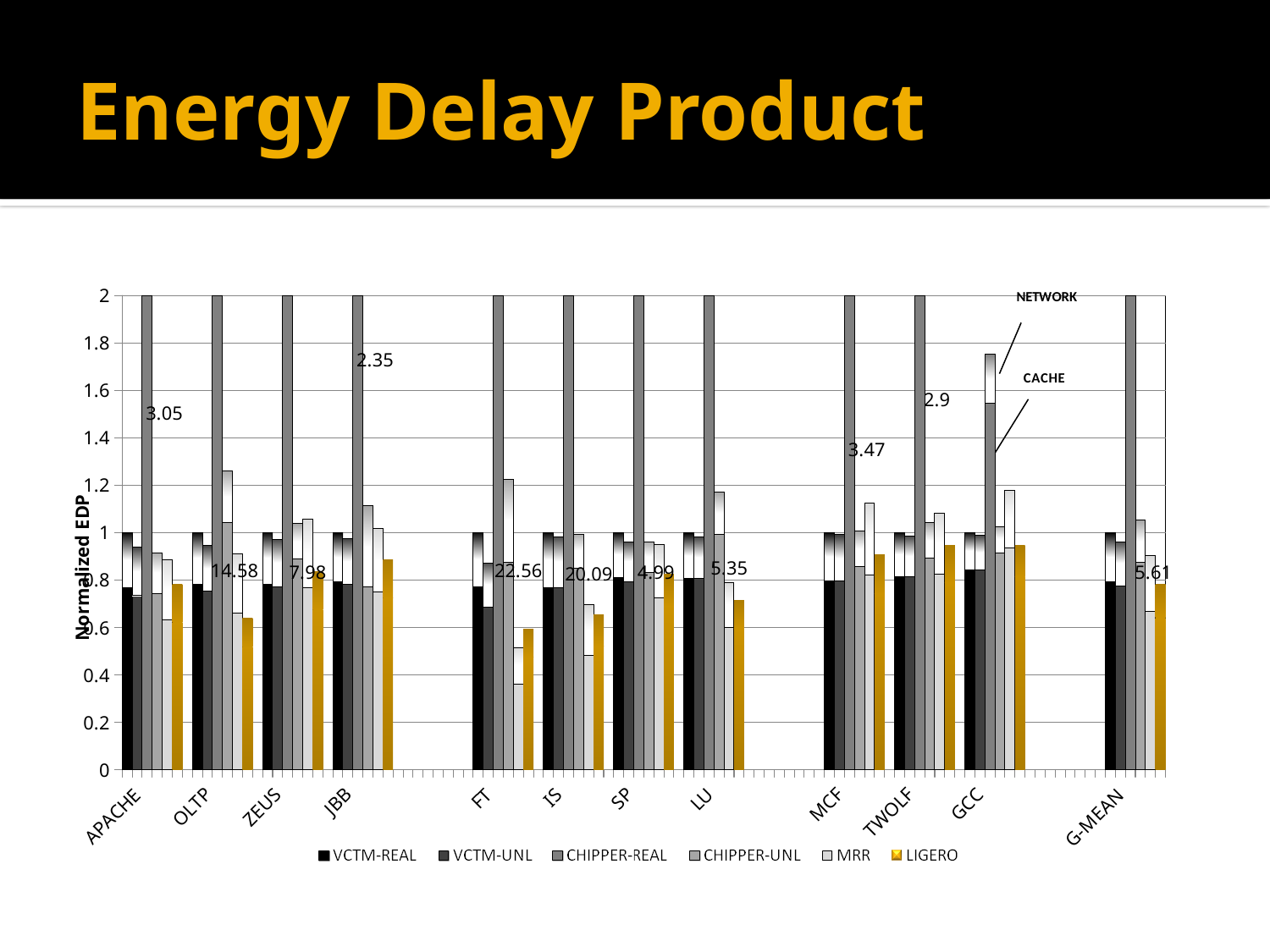
Is the CHIPPER-UNL value for LU greater or less than 1? greater How many benchmark categories are shown on the x axis? 12 What value is printed next to the clipped bar for G-MEAN? 5.61 What kind of chart is shown on the slide? bar chart What is the difference between the printed values for FT and IS? 2.47 Which benchmark has the highest printed value on its clipped bar? FT How many series does the legend list? 6 What is the label of the y axis? Normalized EDP What value is printed next to the clipped bar for FT? 22.56 Which benchmark has the lowest printed value on its clipped bar? JBB What value is printed next to the clipped bar for OLTP? 14.58